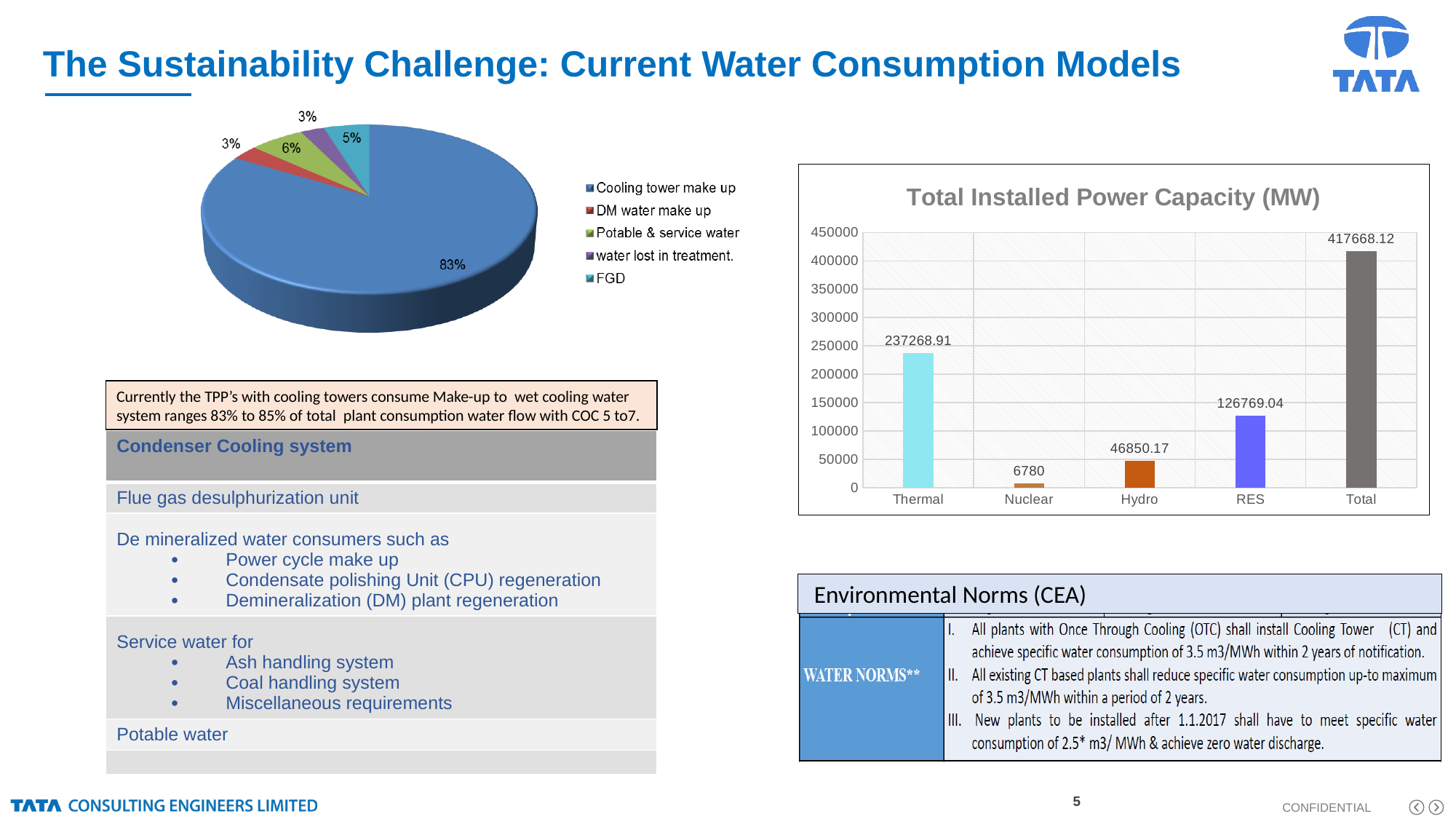
In the pie chart on the left of the slide, what share is labelled for Cooling tower make up? 83% In the bar chart titled 'Total Installed Power Capacity (MW)', what is the value for Nuclear? 6780 In the bar chart titled 'Total Installed Power Capacity (MW)', what is the value for RES? 126769.04 What kind of chart is the one on the left of the slide showing water consumption shares? Pie chart In the bar chart titled 'Total Installed Power Capacity (MW)', which category has the lowest value? Nuclear In the bar chart titled 'Total Installed Power Capacity (MW)', what is the difference between the Hydro and Nuclear values? 40070.17 In the bar chart titled 'Total Installed Power Capacity (MW)', how many categories are shown on the x axis? 5 In the bar chart titled 'Total Installed Power Capacity (MW)', excluding the Total bar, which category has the highest value? Thermal In the pie chart on the left of the slide, what share is labelled for FGD? 5% How many entries does the legend of the pie chart on the left of the slide list? 5 In the bar chart titled 'Total Installed Power Capacity (MW)', which is larger, Hydro or RES? RES In the bar chart titled 'Total Installed Power Capacity (MW)', what is the value for Thermal? 237268.91